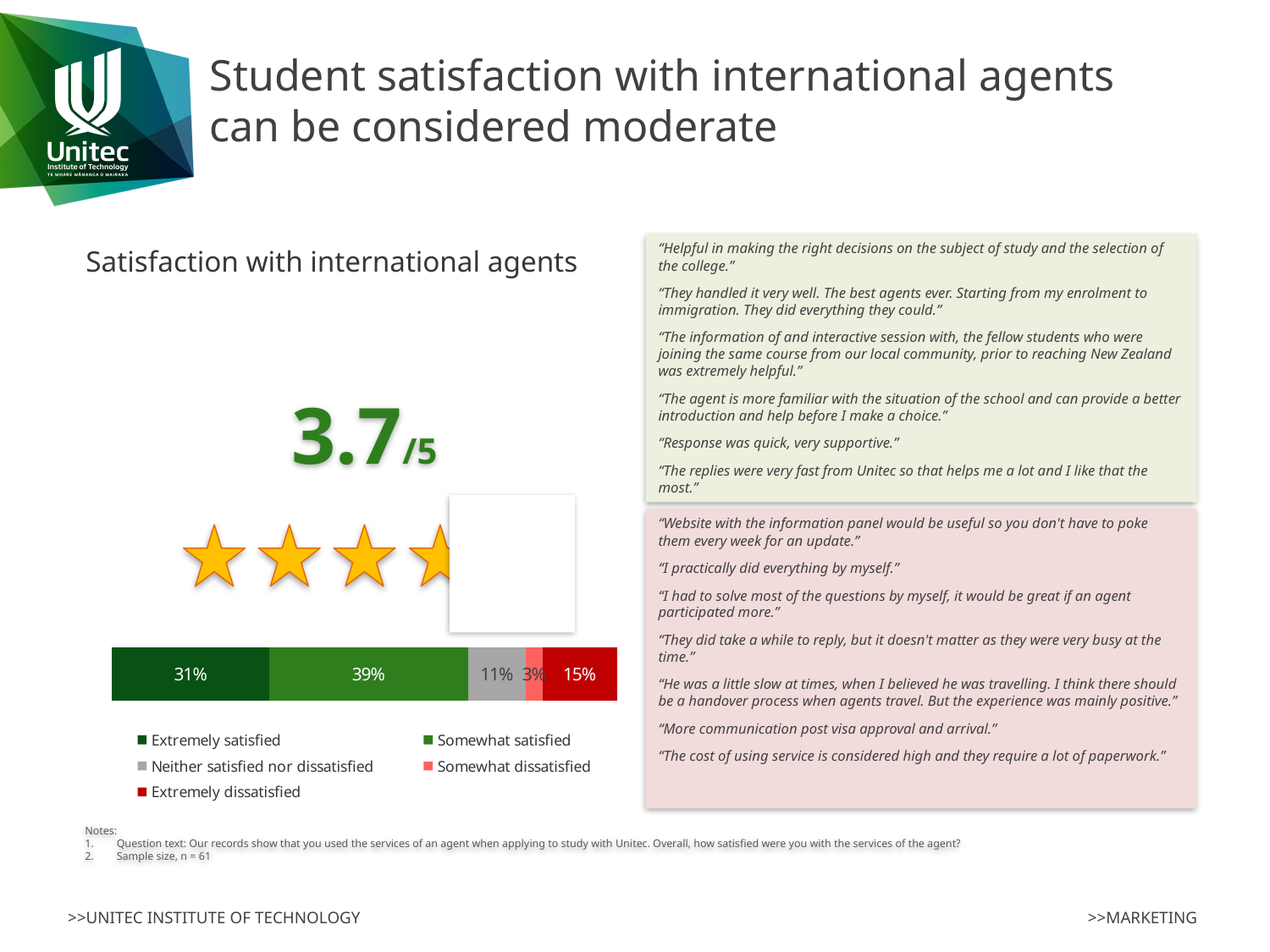
What percentage of respondents were somewhat satisfied with international agents? 39% What percentage of respondents were neither satisfied nor dissatisfied? 11% What percentage of respondents were extremely satisfied with international agents? 31% What is the combined percentage of extremely satisfied and somewhat satisfied respondents? 70% What is the title of the chart on the left of the slide? Satisfaction with international agents What percentage of respondents were extremely dissatisfied with international agents? 15% Which is larger: the share of extremely dissatisfied or the share of neither satisfied nor dissatisfied? Extremely dissatisfied What is the difference in percentage points between somewhat satisfied and extremely satisfied? 8 What kind of chart is used to show the satisfaction breakdown? Stacked bar chart How many satisfaction categories does the legend list? 5 Which satisfaction category has the smallest share in the bar? Somewhat dissatisfied Which satisfaction category has the largest share in the bar? Somewhat satisfied